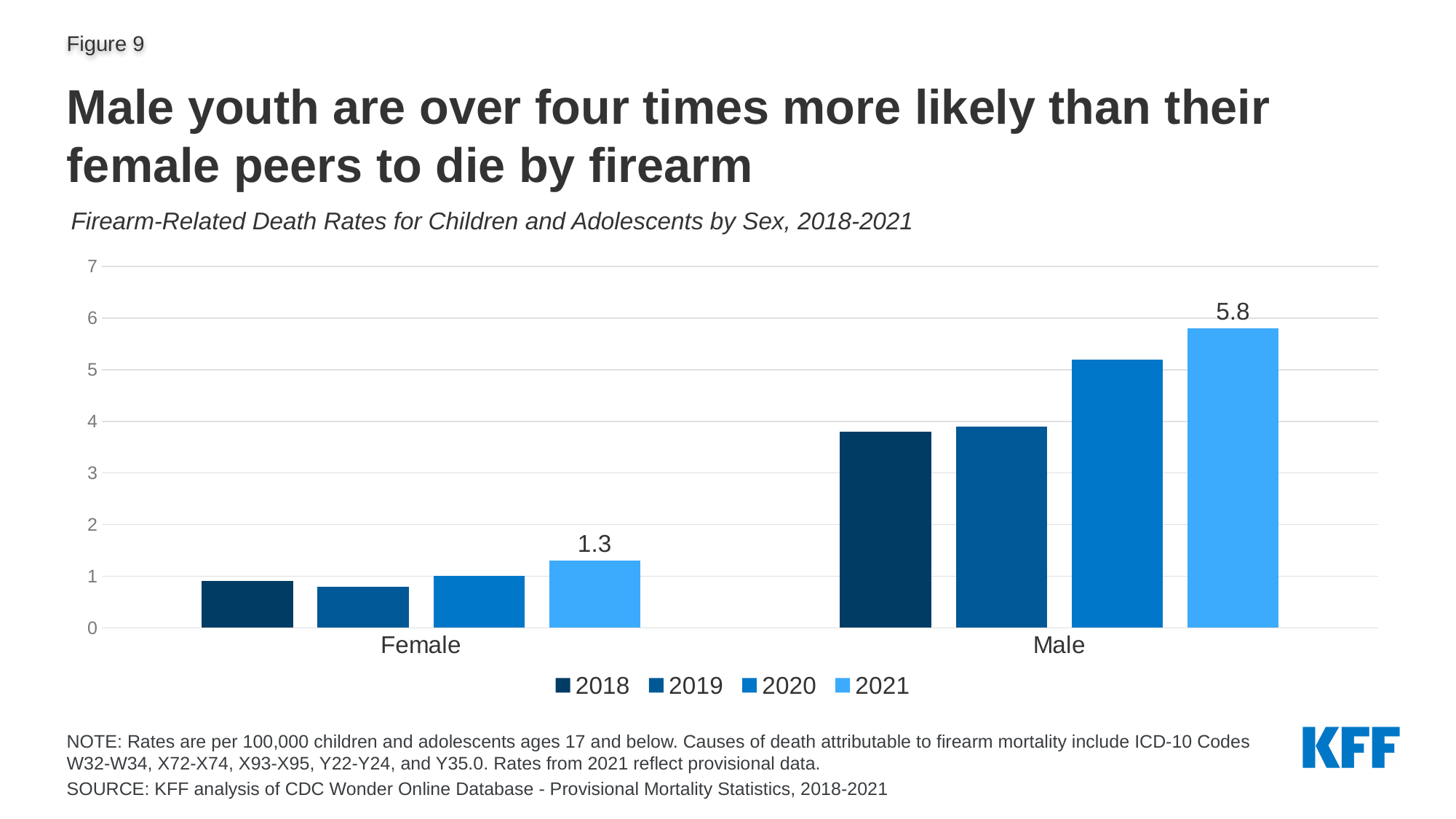
Do the Male values rise or fall from 2018 to 2021? rise What is the firearm-related death rate for Male in 2021? 5.8 What is the firearm-related death rate for Female in 2021? 1.3 Is the value for Male in 2018 greater or less than 4? less Is the value for Male in 2020 greater or less than 4? greater How many series does the legend list? 4 What is the difference between the 2021 rates for Male and Female? 4.5 Is the value for Female in 2019 greater or less than 1? less Which year has the highest rate for Female? 2021 Which has the higher 2021 rate, Male or Female? Male What kind of chart is shown on the slide? bar chart How many categories are shown on the x axis? 2